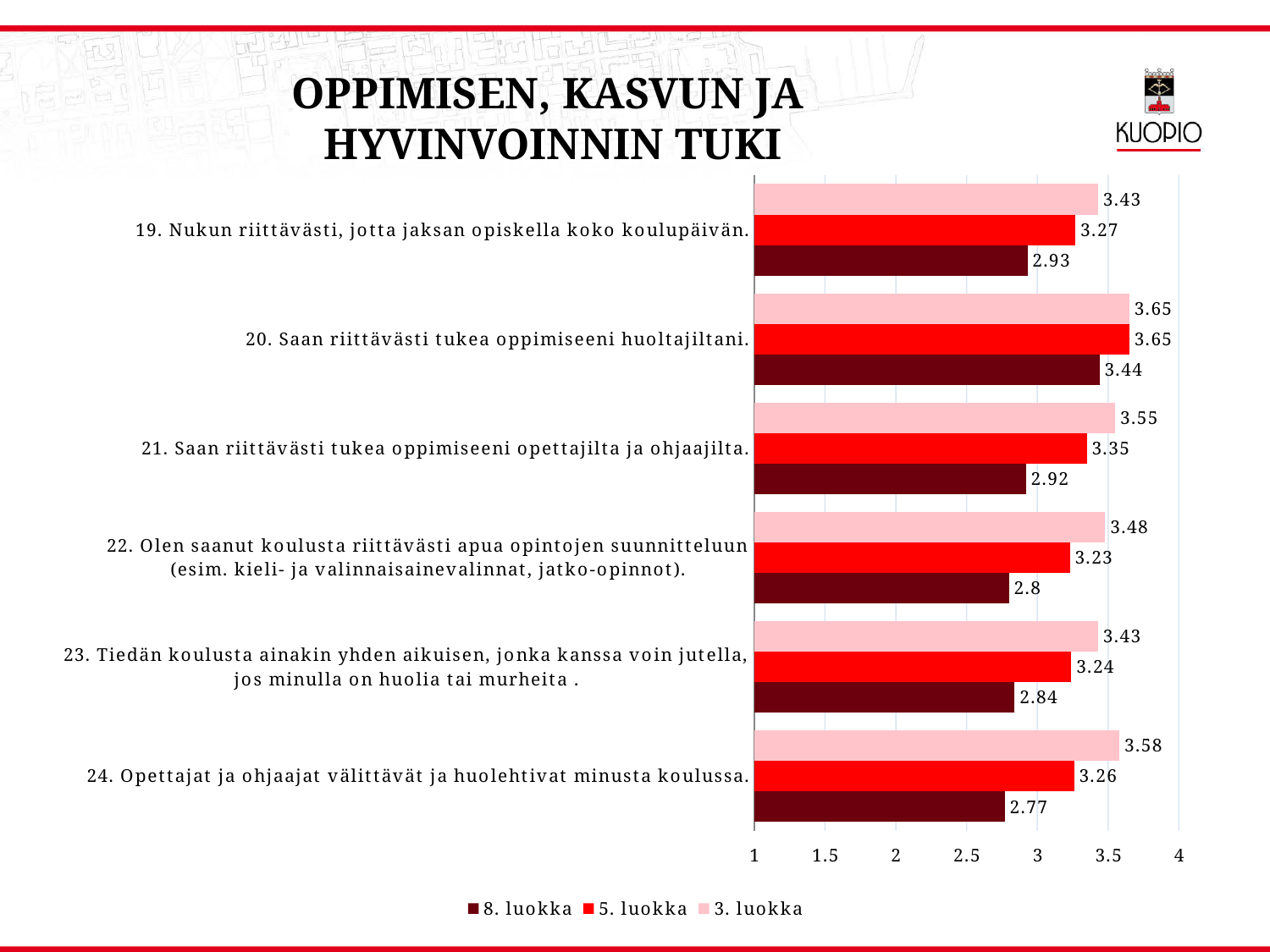
What is the difference between the 3. luokka and 8. luokka values for statement 24? 0.81 What is the value for 3. luokka for statement 24 (Opettajat ja ohjaajat välittävät ja huolehtivat minusta koulussa)? 3.58 Which series is shown in the darkest colour in the legend? 8. luokka What is the value for 5. luokka for statement 22 (Olen saanut koulusta riittävästi apua opintojen suunnitteluun)? 3.23 For statement 21, which is larger: the value for 5. luokka or the value for 8. luokka? 5. luokka What kind of chart is shown on the slide? Bar chart Is the value for 8. luokka for statement 22 greater or less than 3? less Which statement has the lowest value for 8. luokka? 24. Opettajat ja ohjaajat välittävät ja huolehtivat minusta koulussa. How many statements (categories) are shown on the chart? 6 How many series does the legend list? 3 Which statement has the highest value for 8. luokka? 20. Saan riittävästi tukea oppimiseeni huoltajiltani. What is the value for 8. luokka for statement 19 (Nukun riittävästi, jotta jaksan opiskella koko koulupäivän)? 2.93